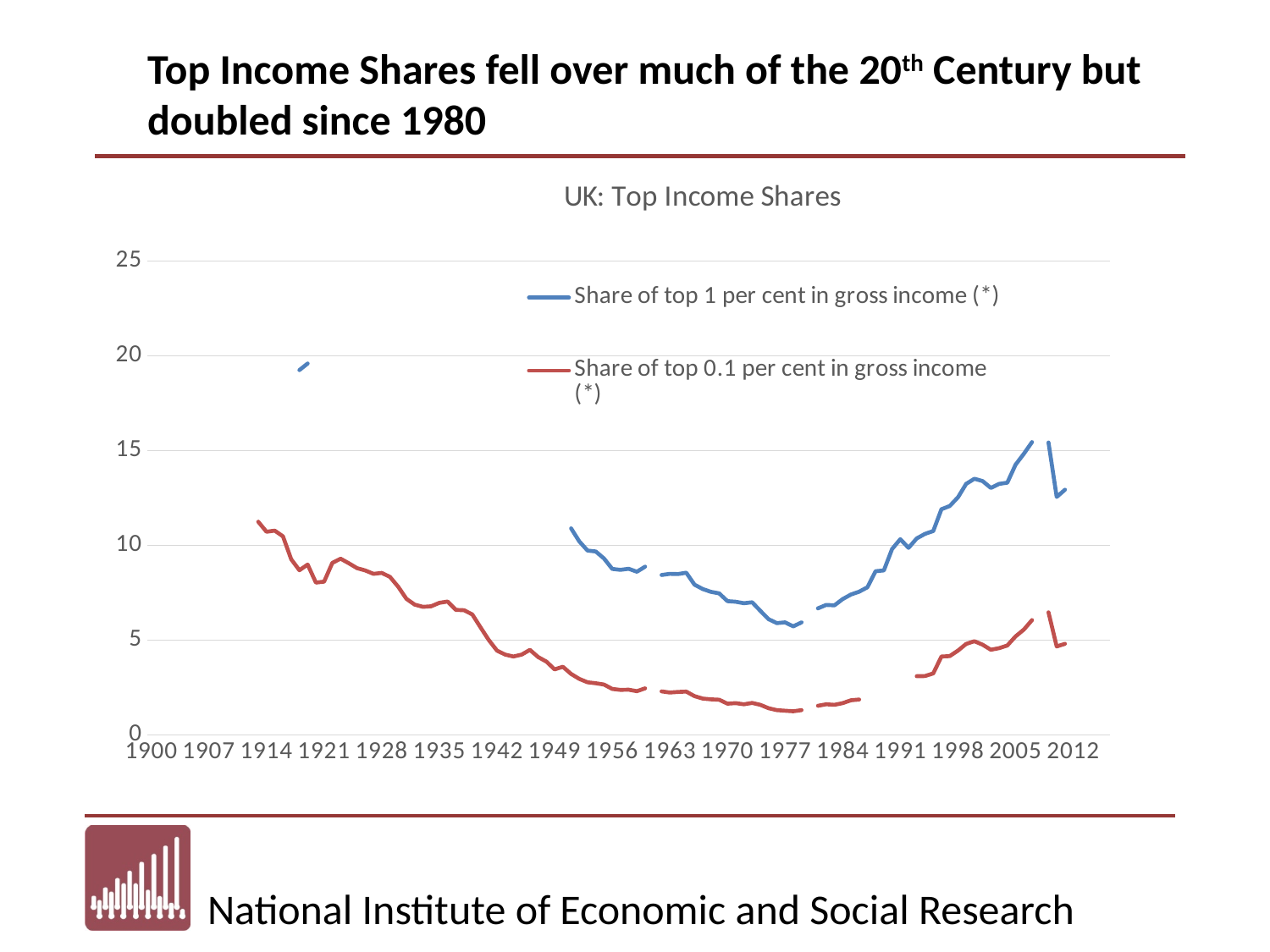
Is the value for Share of top 0.1 per cent in gross income around 1977 greater or less than 5? less Which series is drawn in red? Share of top 0.1 per cent in gross income (*) Is the value for Share of top 0.1 per cent in gross income around 1914 greater or less than 10? greater How many series does the legend list? 2 Is the value for Share of top 1 per cent in gross income around 2005 greater or less than 10? greater What is the title of the chart? UK: Top Income Shares Around 1977, which series has the higher value: Share of top 1 per cent or Share of top 0.1 per cent? Share of top 1 per cent in gross income (*) What kind of chart is shown on the slide? line chart Does the Share of top 1 per cent in gross income rise or fall between 1977 and 2005? rise